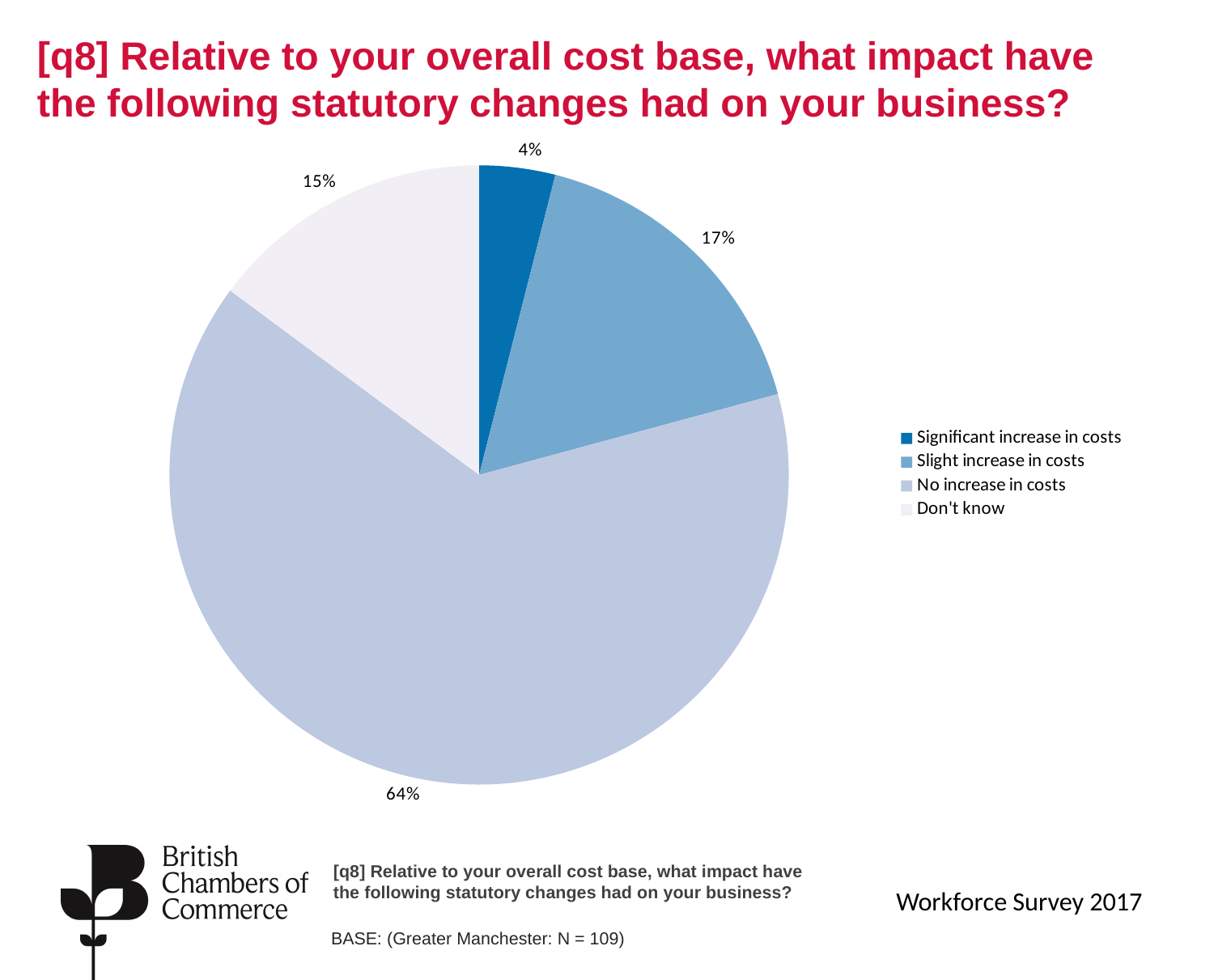
What is the base (sample size) stated for the chart? Greater Manchester: N = 109 How many entries does the legend list? 4 How many slices does the pie chart have? 4 What share of respondents answered 'Don't know'? 15% What is the difference in percentage points between 'No increase in costs' and 'Slight increase in costs'? 47 What kind of chart is shown on the slide? pie chart Which response category has the smallest share of the pie? Significant increase in costs What share of respondents reported a slight increase in costs? 17% What share of respondents reported a significant increase in costs? 4% Which response category has the largest share of the pie? No increase in costs Which is larger: the share for 'Slight increase in costs' or the share for 'Don't know'? Slight increase in costs What share of respondents reported no increase in costs? 64%